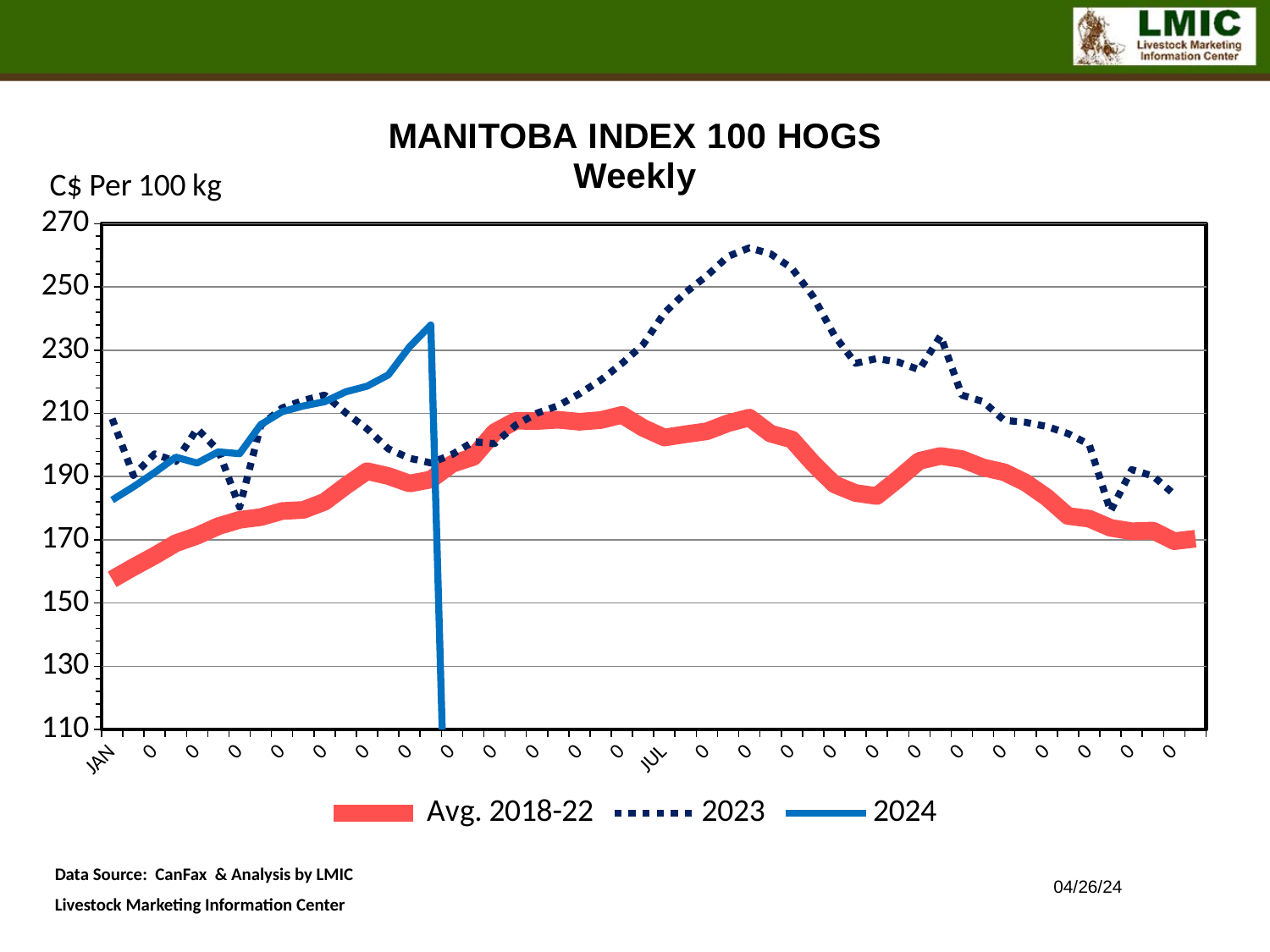
Does the Avg. 2018-22 series rise or fall from JAN to JUL? rise What kind of chart is shown on the slide? line chart What is the title of the chart? MANITOBA INDEX 100 HOGS Weekly Which series reaches the highest value on the chart? 2023 Is the value of the 2024 series at JAN greater or less than 190? less How many series does the legend list? 3 At JAN, which series has the higher value: 2023 or Avg. 2018-22? 2023 Is the value of the 2023 series at JUL greater or less than 210? greater What unit is shown on the y-axis label? C$ Per 100 kg Is the peak value of the 2023 series greater or less than 250? greater